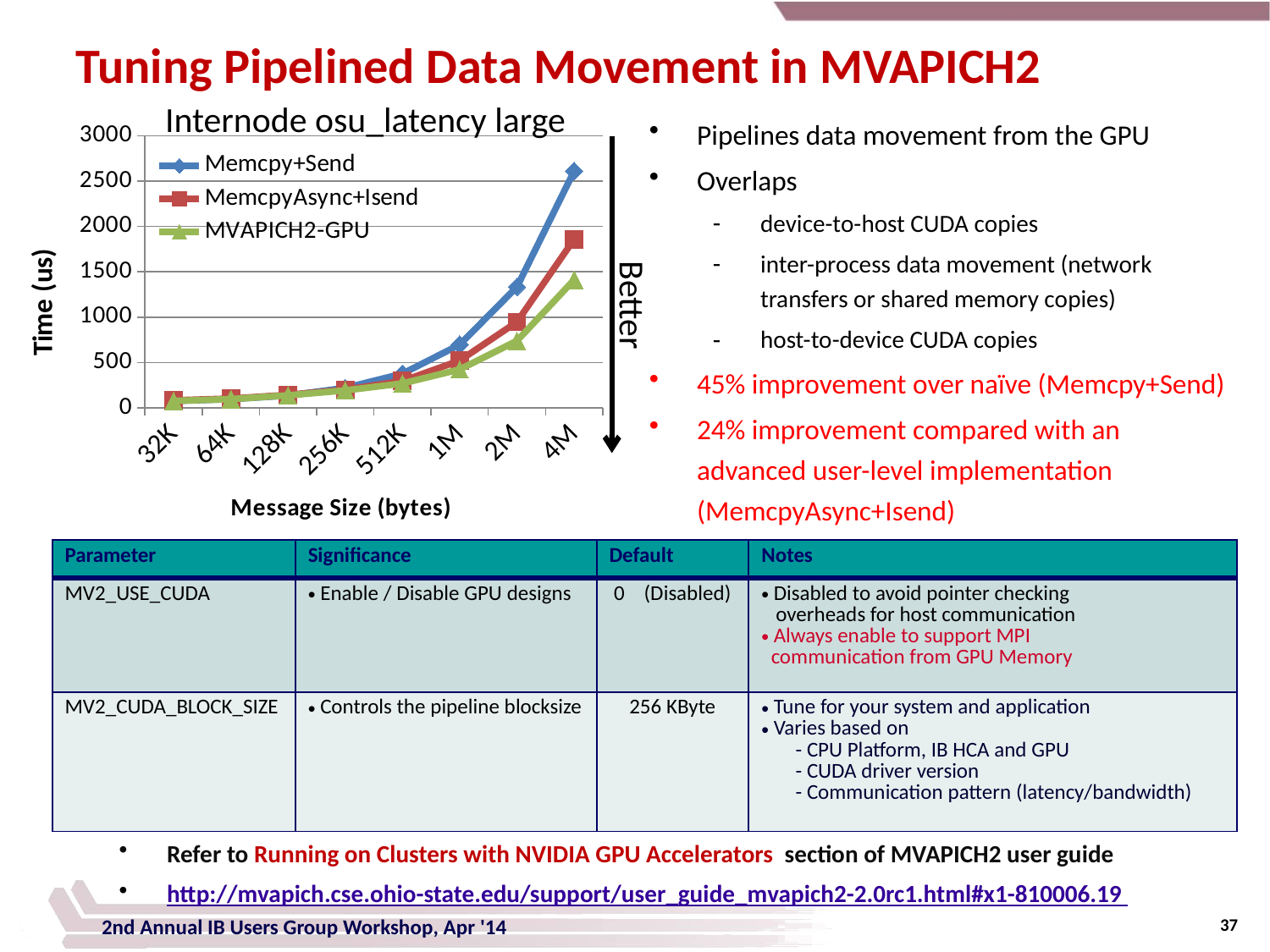
Is the time for MemcpyAsync+Isend at 4M greater or less than 2000? less Do the times rise or fall as message size increases along the x axis? rise What is the label of the chart's y axis? Time (us) Which series has the highest time at the 4M message size? Memcpy+Send Which series has the lowest time at the 4M message size? MVAPICH2-GPU How many series does the chart legend list? 3 What kind of chart is shown on the slide? line chart At the 2M message size, which is larger: the time for Memcpy+Send or for MVAPICH2-GPU? Memcpy+Send Is the time for Memcpy+Send at 4M greater or less than 2000? greater What is the title of the chart? Internode osu_latency large Is the time for MVAPICH2-GPU at 4M greater or less than 1000? greater How many message sizes are plotted along the x axis of the chart? 8